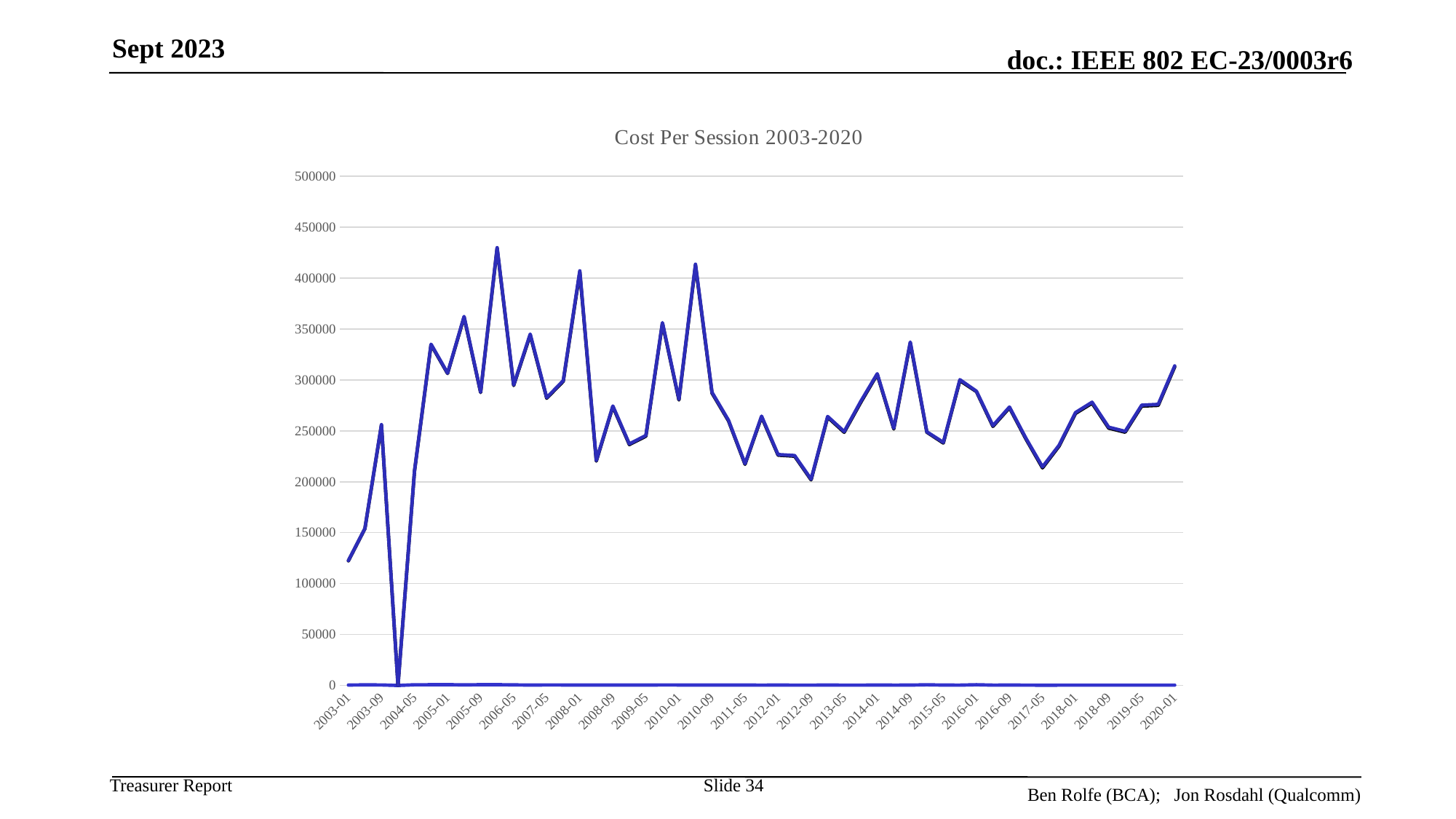
What is the lowest value plotted on the line? 0 Is the value for 2020-01 greater or less than 250000? greater How many date labels are shown along the x axis? 26 Is the value for 2003-01 greater or less than 200000? less What is the highest value shown on the vertical axis? 500000 Is the highest value plotted on the chart greater or less than 400000? greater What is the title of the chart? Cost Per Session 2003-2020 Does the line rise or fall between 2003-01 and 2003-09? rise What kind of chart is shown on the slide? line chart